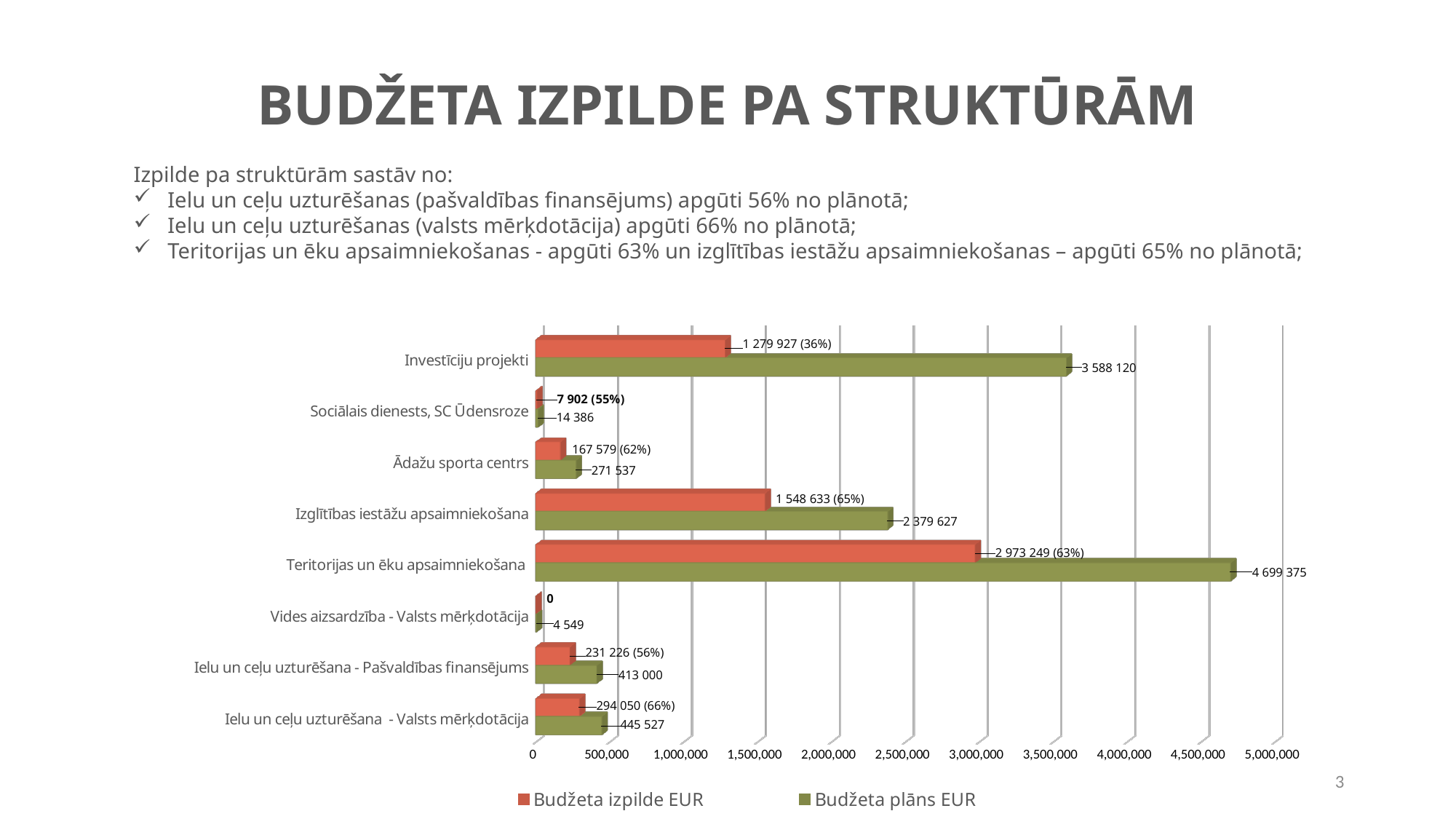
Which series is shown in green on the chart? Budžeta plāns EUR What is the Budžeta plāns EUR value for Teritorijas un ēku apsaimniekošana? 4 699 375 What is the difference between the Budžeta plāns EUR and Budžeta izpilde EUR values for Teritorijas un ēku apsaimniekošana? 1 726 126 Which is larger: the Budžeta izpilde EUR value for Izglītības iestāžu apsaimniekošana or for Investīciju projekti? Izglītības iestāžu apsaimniekošana What is the Budžeta izpilde EUR value for Vides aizsardzība - Valsts mērķdotācija? 0 Which category has the lowest Budžeta plāns EUR value? Vides aizsardzība - Valsts mērķdotācija What type of chart is shown on the slide? Bar chart How many series does the chart legend list? 2 What is the Budžeta izpilde EUR value for Investīciju projekti? 1 279 927 (36%) What is the Budžeta plāns EUR value for Ādažu sporta centrs? 271 537 How many categories are shown on the chart? 8 Which category has the highest Budžeta plāns EUR value? Teritorijas un ēku apsaimniekošana